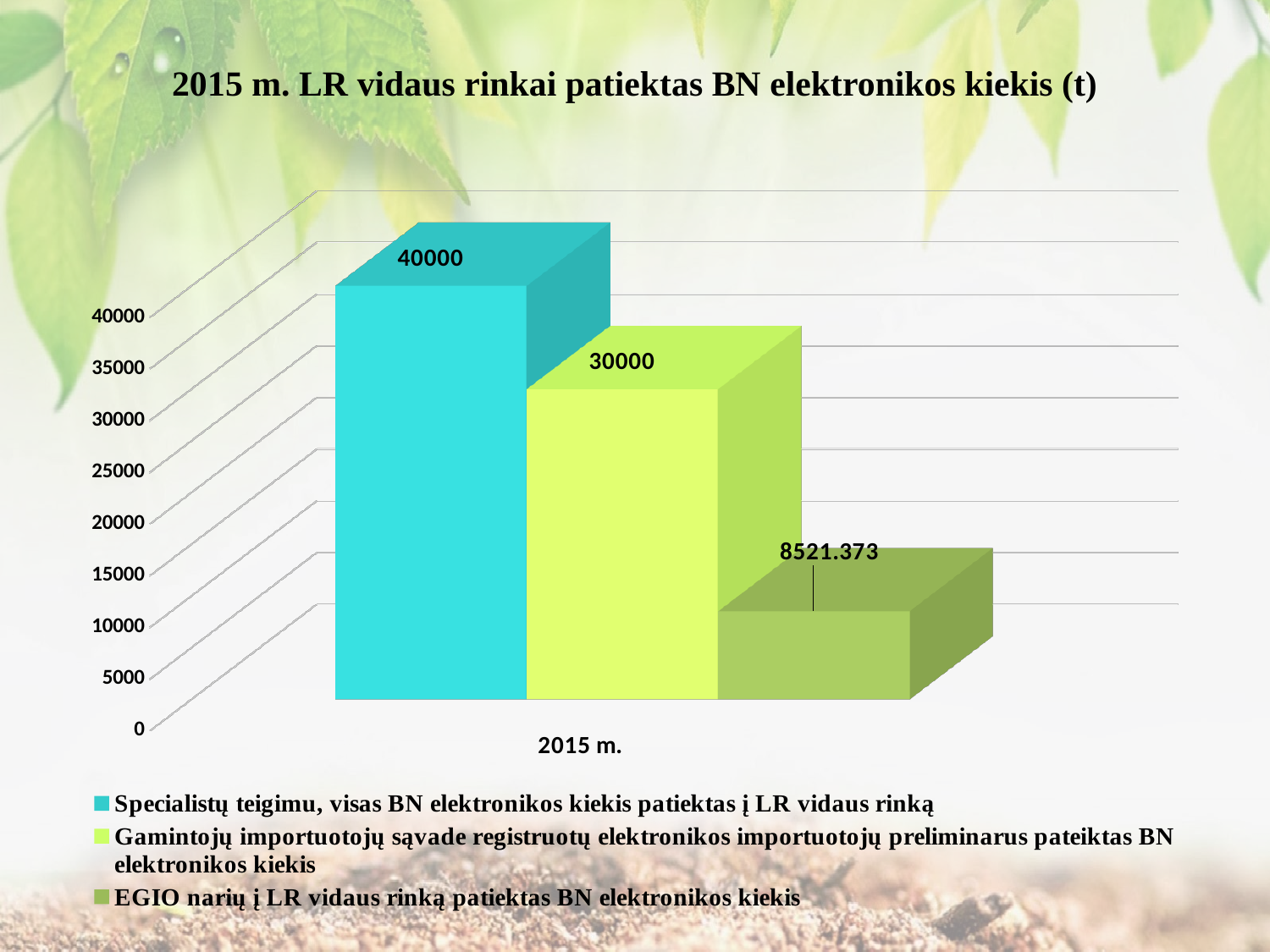
How many categories are shown on the x axis? 1 What is the value for the series 'Gamintojų importuotojų sąvade registruotų elektronikos importuotojų preliminarus pateiktas BN elektronikos kiekis'? 30000 Which series has the lowest value? EGIO narių į LR vidaus rinką patiektas BN elektronikos kiekis How many series does the legend list? 3 Is the value for 'EGIO narių į LR vidaus rinką patiektas BN elektronikos kiekis' greater or less than 10000? less Which is larger: the 'Gamintojų importuotojų sąvade' value or the 'EGIO narių' value? Gamintojų importuotojų sąvade registruotų elektronikos importuotojų preliminarus pateiktas BN elektronikos kiekis What is the value for the series 'EGIO narių į LR vidaus rinką patiektas BN elektronikos kiekis'? 8521.373 What is the value for the series 'Specialistų teigimu, visas BN elektronikos kiekis patiektas į LR vidaus rinką'? 40000 What is the title of the chart? 2015 m. LR vidaus rinkai patiektas BN elektronikos kiekis (t) Which series has the highest value? Specialistų teigimu, visas BN elektronikos kiekis patiektas į LR vidaus rinką What is the difference between the 'Specialistų teigimu' value and the 'Gamintojų importuotojų sąvade' value? 10000 What kind of chart is shown on the slide? bar chart